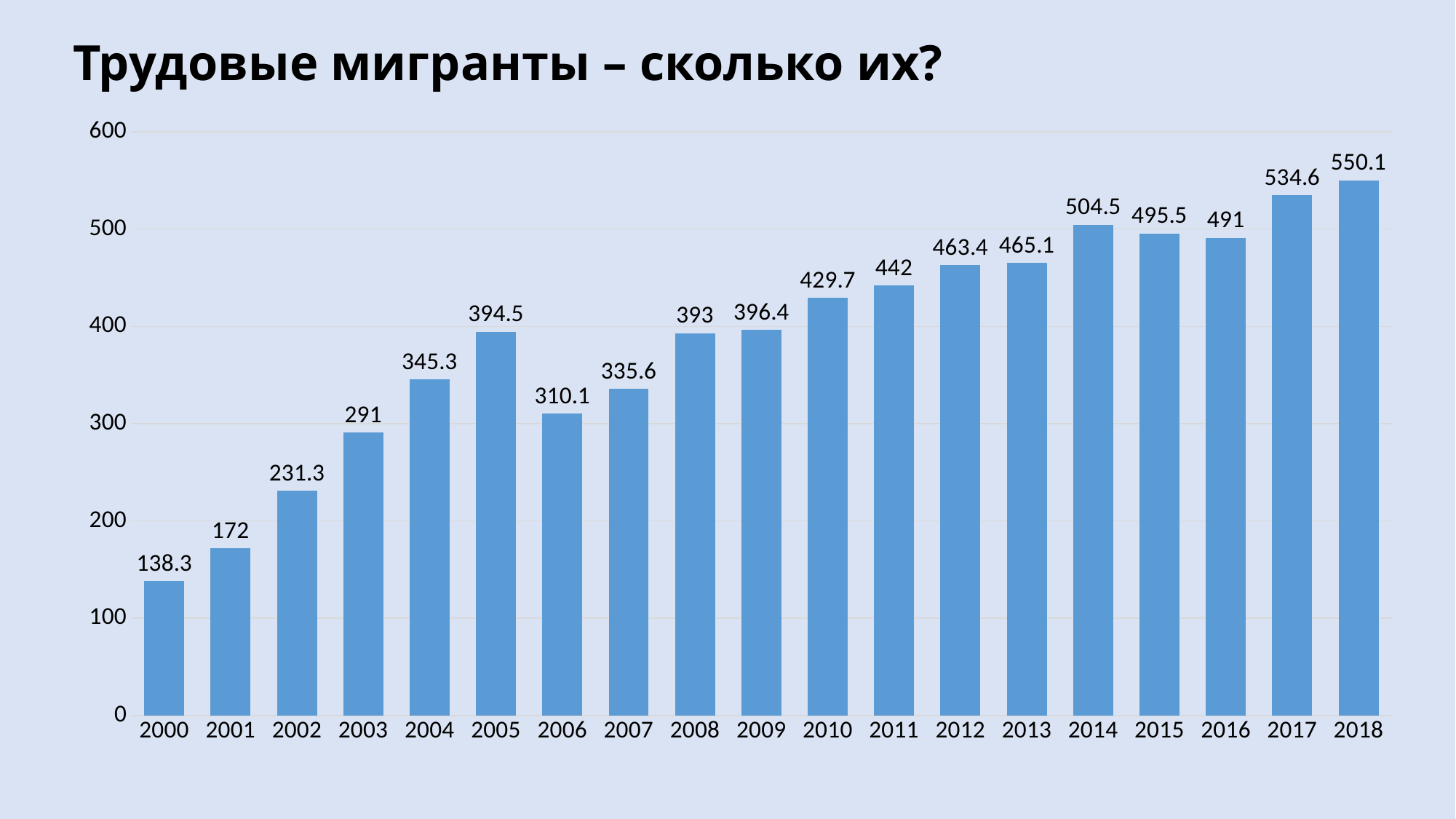
What is the value for 2000? 138.3 Is the value for 2003 greater or less than 300? less What is the value for 2016? 491 Which year has the highest value? 2018 What is the difference between the values for 2018 and 2017? 15.5 What kind of chart is shown on the slide? bar chart What is the title of the chart? Трудовые мигранты – сколько их? Which is larger, the value for 2014 or the value for 2015? 2014 What is the difference between the values for 2005 and 2006? 84.4 Which year has the lowest value? 2000 What is the value for 2010? 429.7 How many years are shown on the x axis? 19